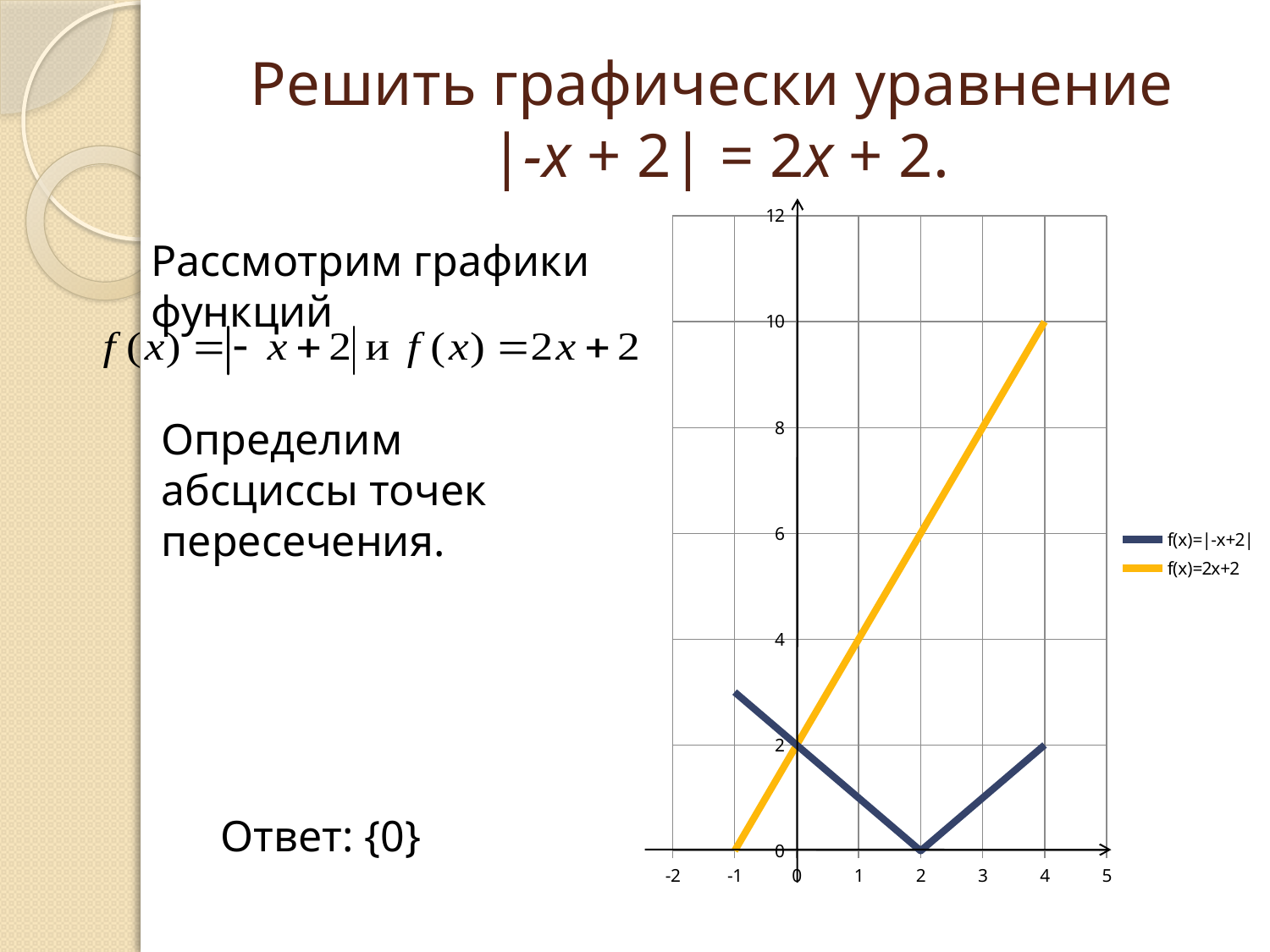
Does the line f(x)=2x+2 rise or fall as x increases? rises What is the value of f(x)=2x+2 at x = 4? 10 What is the value of f(x)=|-x+2| at x = 4? 2 What are the two series named in the legend? f(x)=|-x+2| and f(x)=2x+2 At x = 4, which series has the larger value, f(x)=|-x+2| or f(x)=2x+2? f(x)=2x+2 What is the value of f(x)=|-x+2| at x = 2? 0 At which x value do the two lines intersect? 0 How many series does the legend list? 2 Is the value of f(x)=|-x+2| at x = -1 greater or less than 2? greater What is the value of f(x)=2x+2 at x = -1? 0 What colour is the line for f(x)=2x+2? orange What kind of chart is shown on the slide? line chart